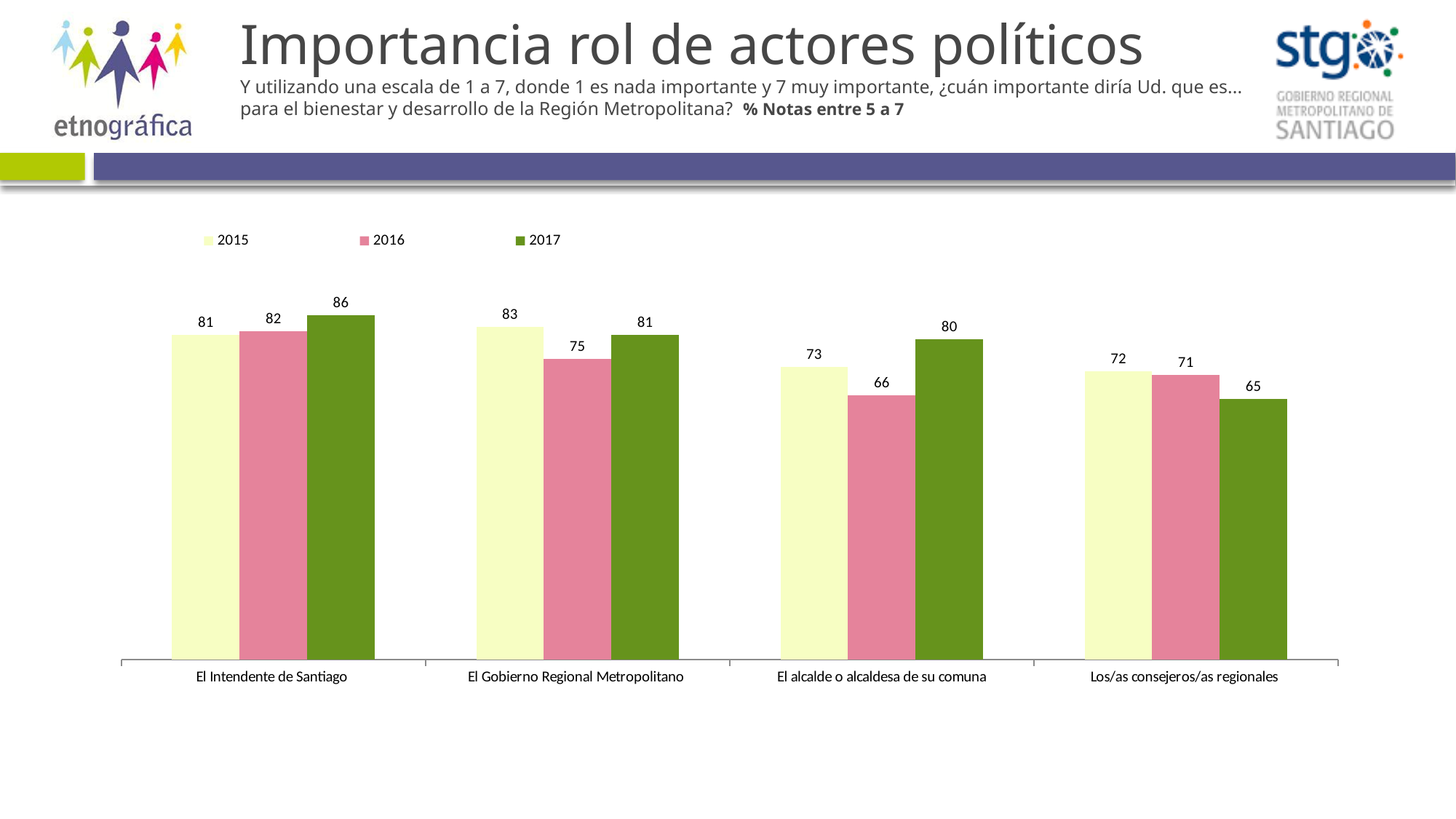
What kind of chart is shown on the slide? bar chart Which series is shown in dark green in the legend? 2017 How many categories are shown on the x axis? 4 Do the 2017 values rise or fall from El Intendente de Santiago to Los/as consejeros/as regionales? fall What is the 2017 value for El Intendente de Santiago? 86 What is the 2016 value for El alcalde o alcaldesa de su comuna? 66 Which is larger for Los/as consejeros/as regionales: the 2015 value or the 2017 value? 2015 Which category has the lowest 2016 value? El alcalde o alcaldesa de su comuna What is the difference between the 2017 and 2016 values for El alcalde o alcaldesa de su comuna? 14 What is the 2015 value for El Gobierno Regional Metropolitano? 83 Which category has the highest 2017 value? El Intendente de Santiago How many series does the legend list? 3